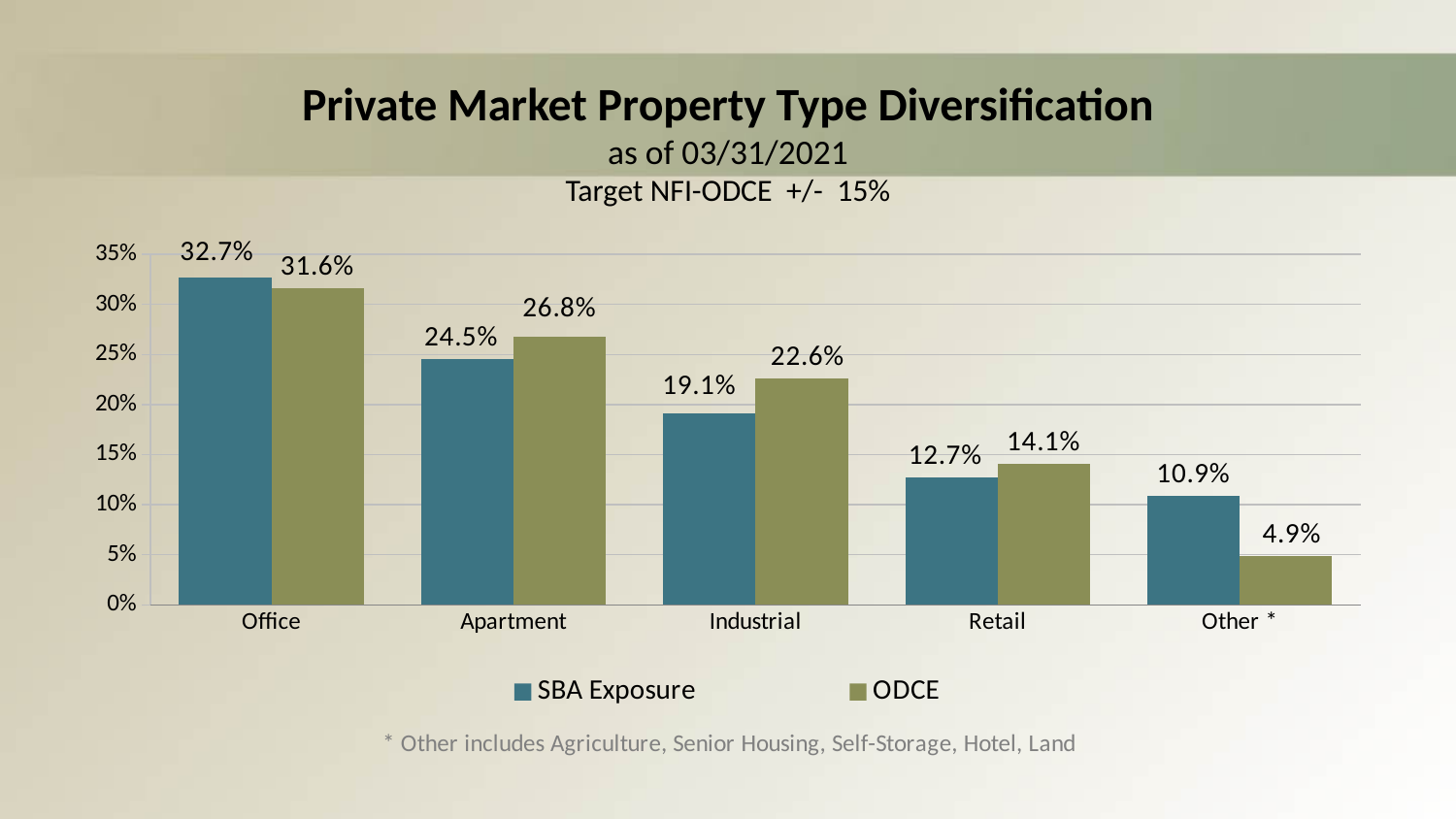
How many property type categories are shown on the x axis? 5 What is the ODCE value for Apartment? 26.8% What is the difference between the ODCE and SBA Exposure values for Industrial? 3.5% Do the SBA Exposure values rise or fall from Office to Other * along the x axis? Fall What is the SBA Exposure value for Office? 32.7% For Retail, which is larger: SBA Exposure or ODCE? ODCE Which property type has the lowest ODCE value? Other * Which property type has the highest SBA Exposure value? Office What is the title of the chart? Private Market Property Type Diversification What is the ODCE value for Other *? 4.9% What kind of chart is shown on the slide? Bar chart How many series does the legend list? 2